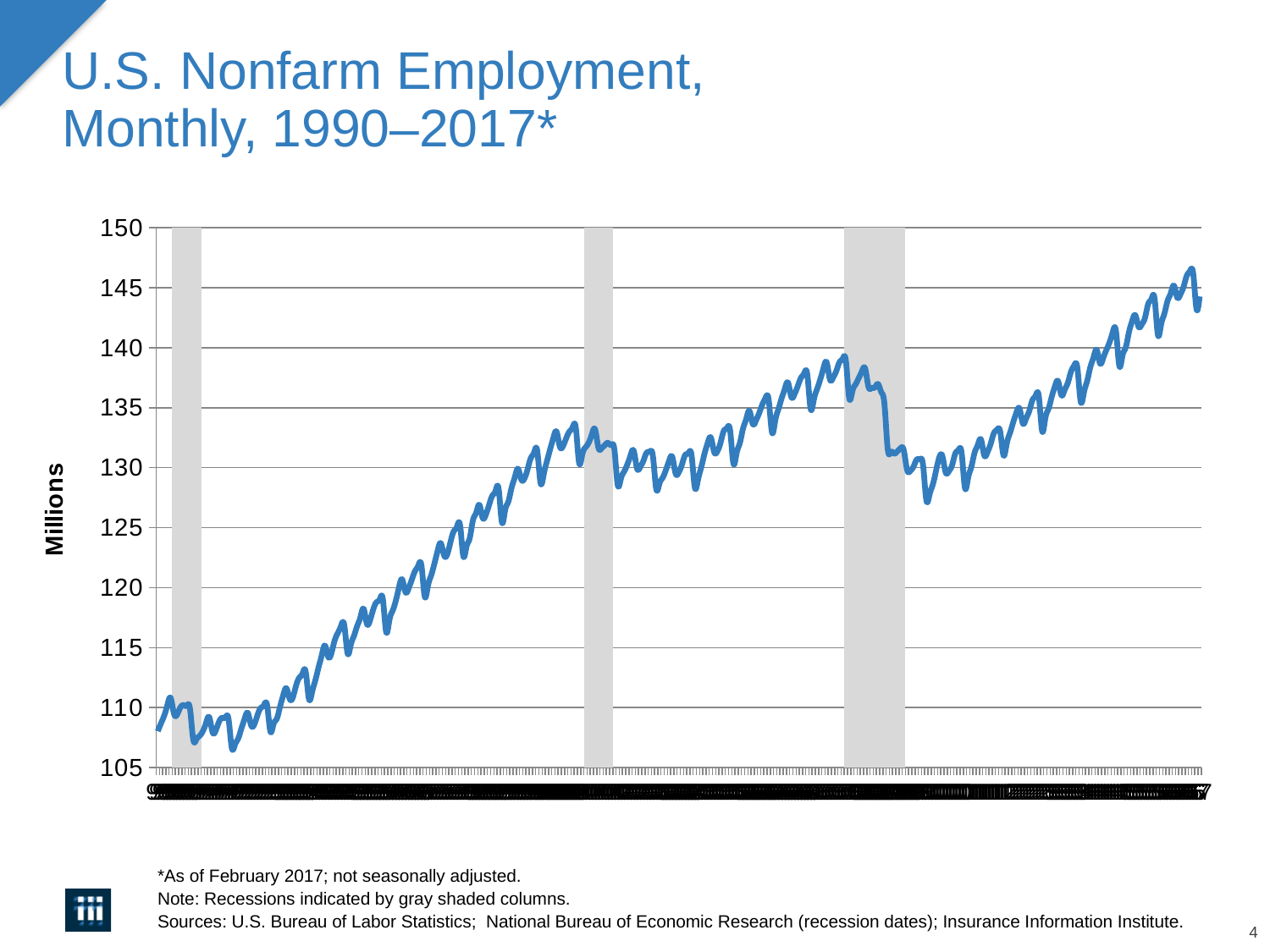
What is the title of the chart? U.S. Nonfarm Employment, Monthly, 1990–2017* What is the highest value shown on the vertical axis? 150 Is the value at the start of the series (left end of the line) greater or less than 115? less Overall, does the employment line rise or fall from the left of the chart to the right? Rise What is the lowest value shown on the vertical axis? 105 Is the highest value reached by the line greater or less than 145? greater What kind of chart is shown on the slide? Line chart Is the value at the end of the series (right end of the line) greater or less than 140? greater Is the value at the end of the series (right end of the line) greater or less than the value at the start of the series (left end)? greater How many lines (data series) are plotted on the chart? 1 What is the label on the vertical axis of the chart? Millions